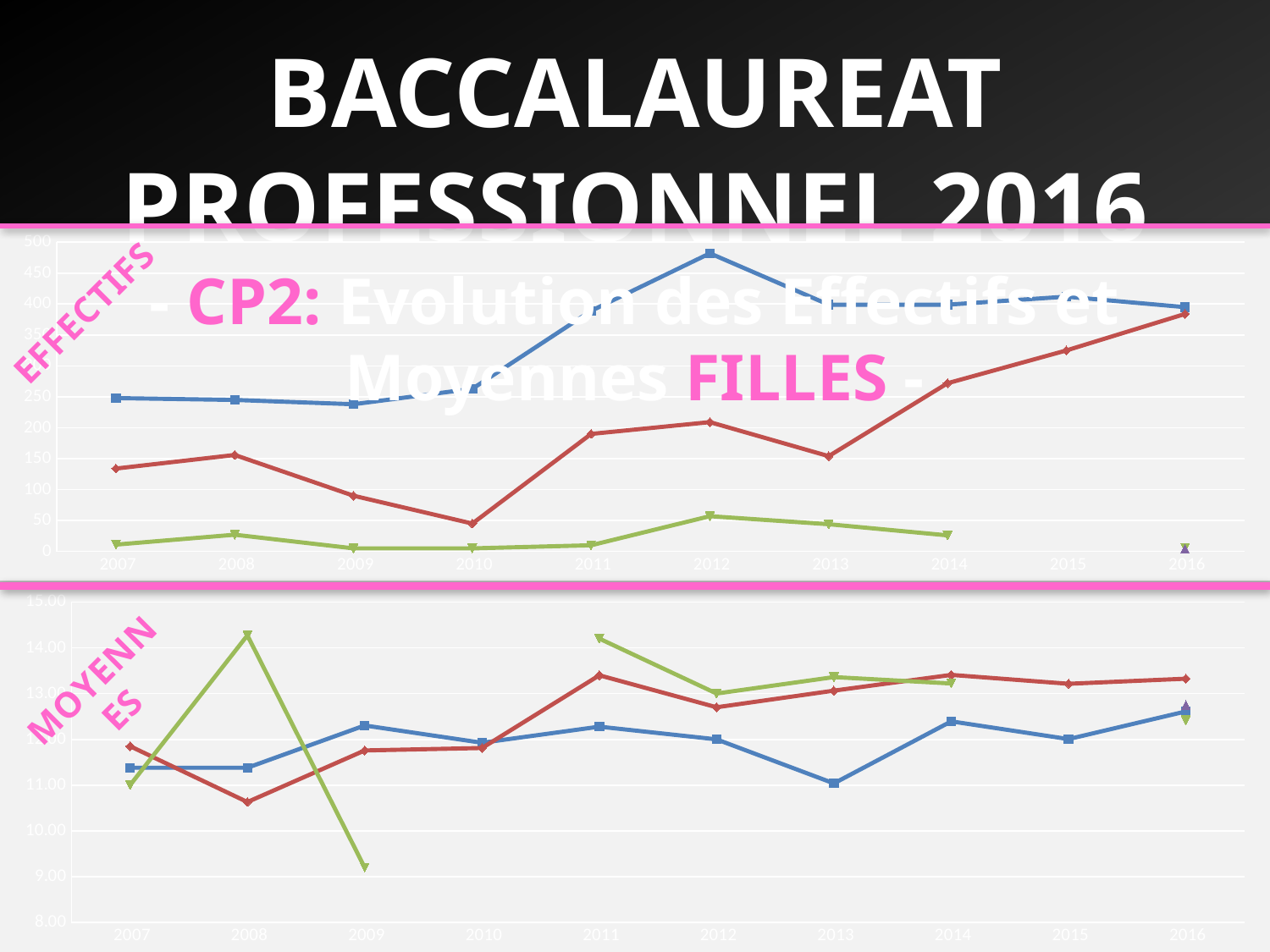
In the top chart (EFFECTIFS), in which year does the blue line reach its highest value? 2012 How many years are shown on the x axis of the top chart (EFFECTIFS)? 10 In the top chart (EFFECTIFS), is the value of the red line in 2010 greater or less than 100? less In the top chart (EFFECTIFS), which line is higher in 2011, the blue line or the green line? the blue line In the top chart (EFFECTIFS), does the red line rise or fall from 2013 to 2016? rise What is the highest value shown on the y axis of the bottom chart (MOYENNES)? 15.00 What kind of chart is the top chart labelled EFFECTIFS? line chart In the bottom chart (MOYENNES), is the value of the blue line in 2013 greater or less than 12.00? less In the top chart (EFFECTIFS), in which year does the red line reach its lowest value? 2010 In the bottom chart (MOYENNES), is the value of the green line in 2009 greater or less than 10.00? less In the bottom chart (MOYENNES), in which year does the green line reach its lowest value? 2009